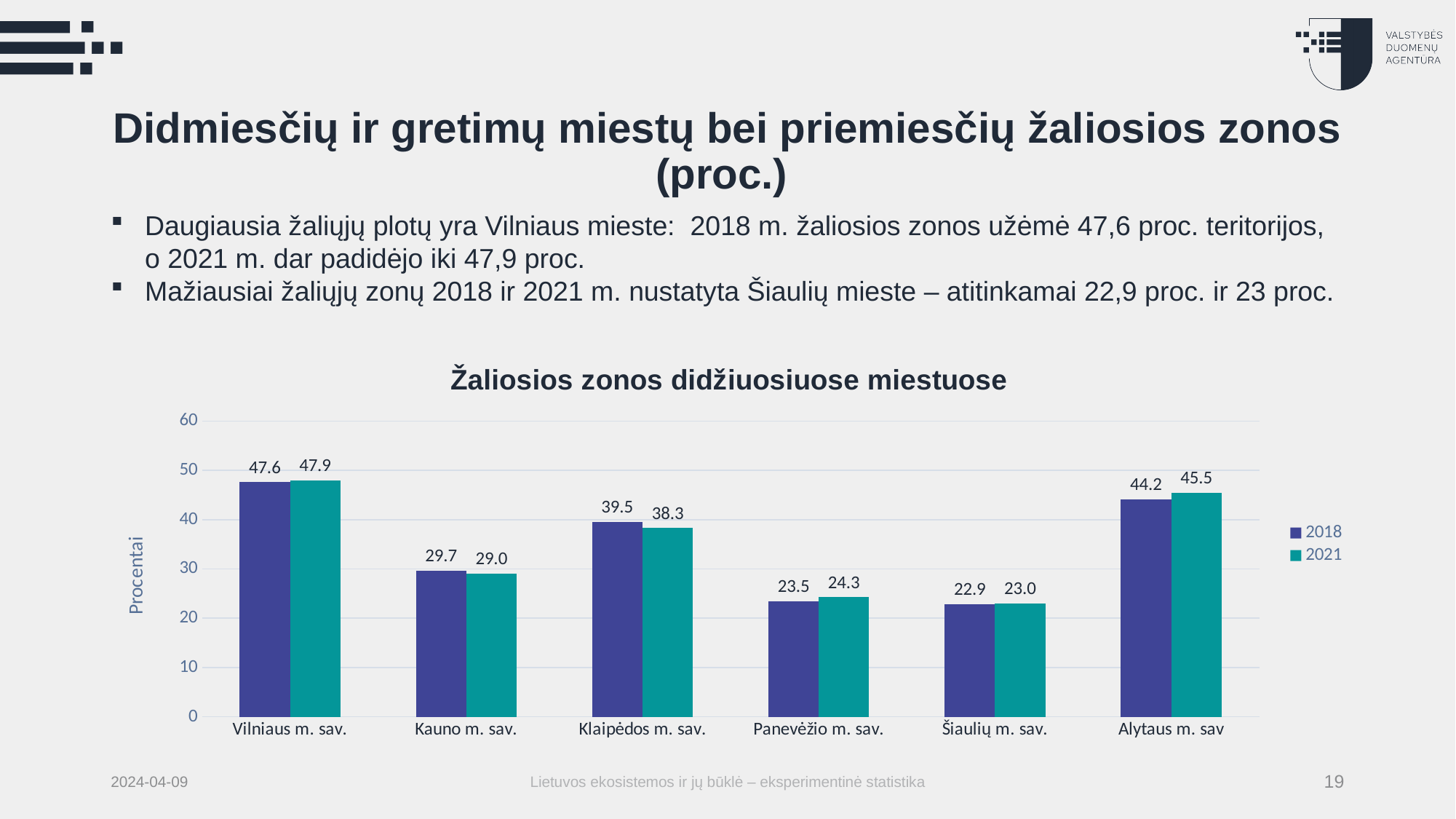
How many categories are shown on the x axis? 6 What is the difference between the 2021 and 2018 values for Alytaus m. sav? 1.3 What kind of chart is shown? bar chart Which category has the lowest 2018 value? Šiaulių m. sav. What is the title of the chart? Žaliosios zonos didžiuosiuose miestuose Is the 2018 value for Panevėžio m. sav. greater or less than 30? less Which category has the highest 2021 value? Vilniaus m. sav. What is the 2021 value for Klaipėdos m. sav.? 38.3 What is the 2021 value for Alytaus m. sav? 45.5 How many series does the legend list? 2 Which is larger for Kauno m. sav.: the 2018 value or the 2021 value? 2018 What is the 2018 value for Vilniaus m. sav.? 47.6